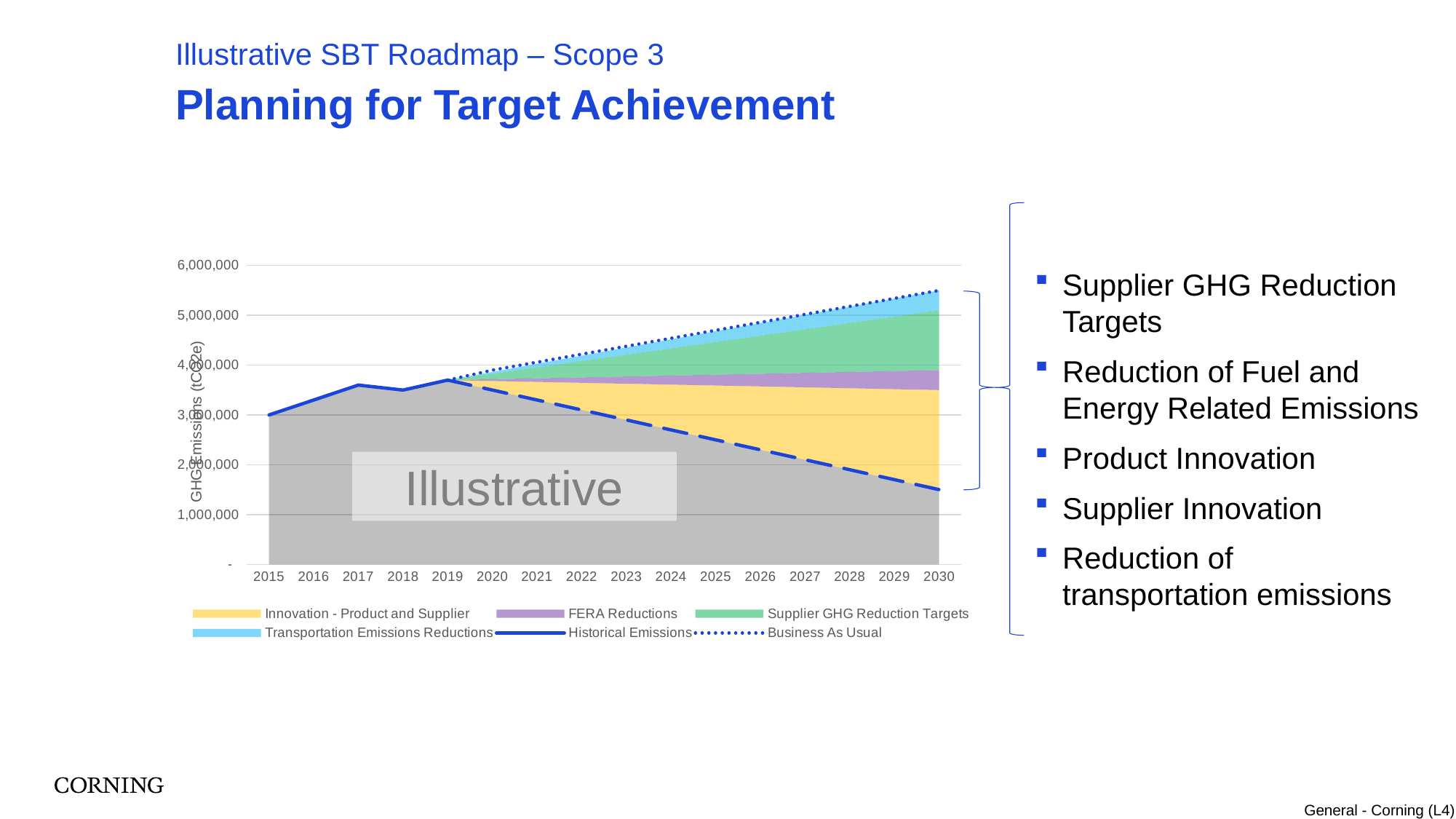
How many years are shown on the x axis of the chart? 16 Does the dashed blue line rise or fall from 2019 to 2030? Falls In which year between 2015 and 2019 is the Historical Emissions line highest? 2019 Which legend entry is shown in yellow? Innovation - Product and Supplier Is the value of the dashed blue line in 2030 greater or less than 2,000,000? less Is the Business As Usual value in 2030 greater or less than 5,000,000? greater How many series does the chart legend list? 6 Does the Business As Usual line rise or fall from 2019 to 2030? Rises Is the Historical Emissions value in 2019 greater or less than 3,000,000? greater What is the label of the y axis of the chart? GHG Emissions (tCO2e) What kind of chart is shown on the slide? Area chart with line series Which is larger: the Business As Usual value in 2030 or the Historical Emissions value in 2019? Business As Usual in 2030